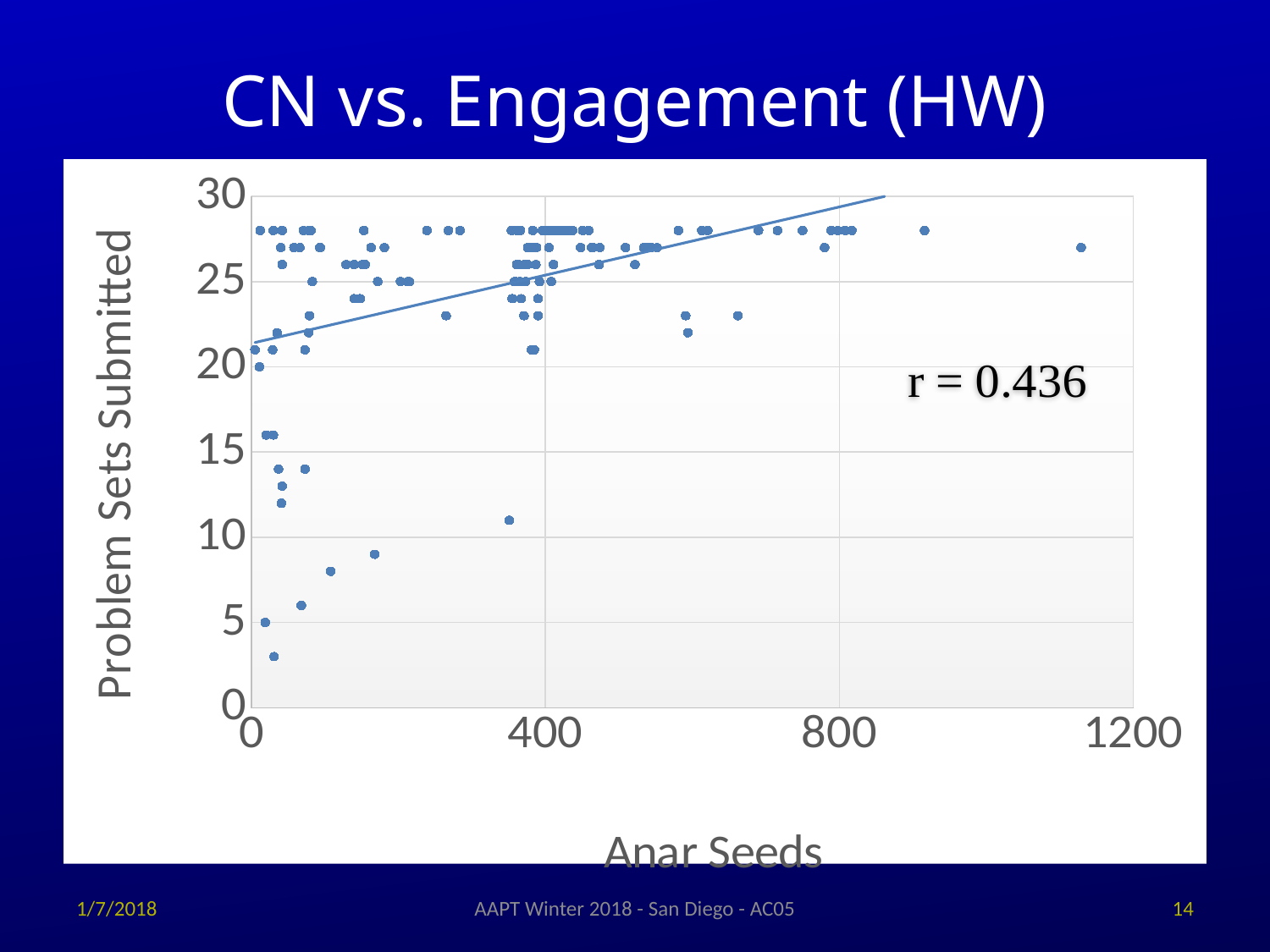
What correlation coefficient r is printed on the chart? r = 0.436 Is the Problem Sets Submitted value for the lowest point on the chart greater or less than 5? less What is the label of the x axis? Anar Seeds What kind of chart is shown on the slide? scatter plot What is the highest tick value shown on the y axis? 30 Is the Anar Seeds value for the rightmost point greater or less than 800? greater Is the Problem Sets Submitted value for the rightmost point (near 1130 Anar Seeds) greater or less than 25? greater What is the title of the chart? CN vs. Engagement (HW) Does the trend line rise or fall as Anar Seeds increases? rises What is the highest tick value shown on the x axis? 1200